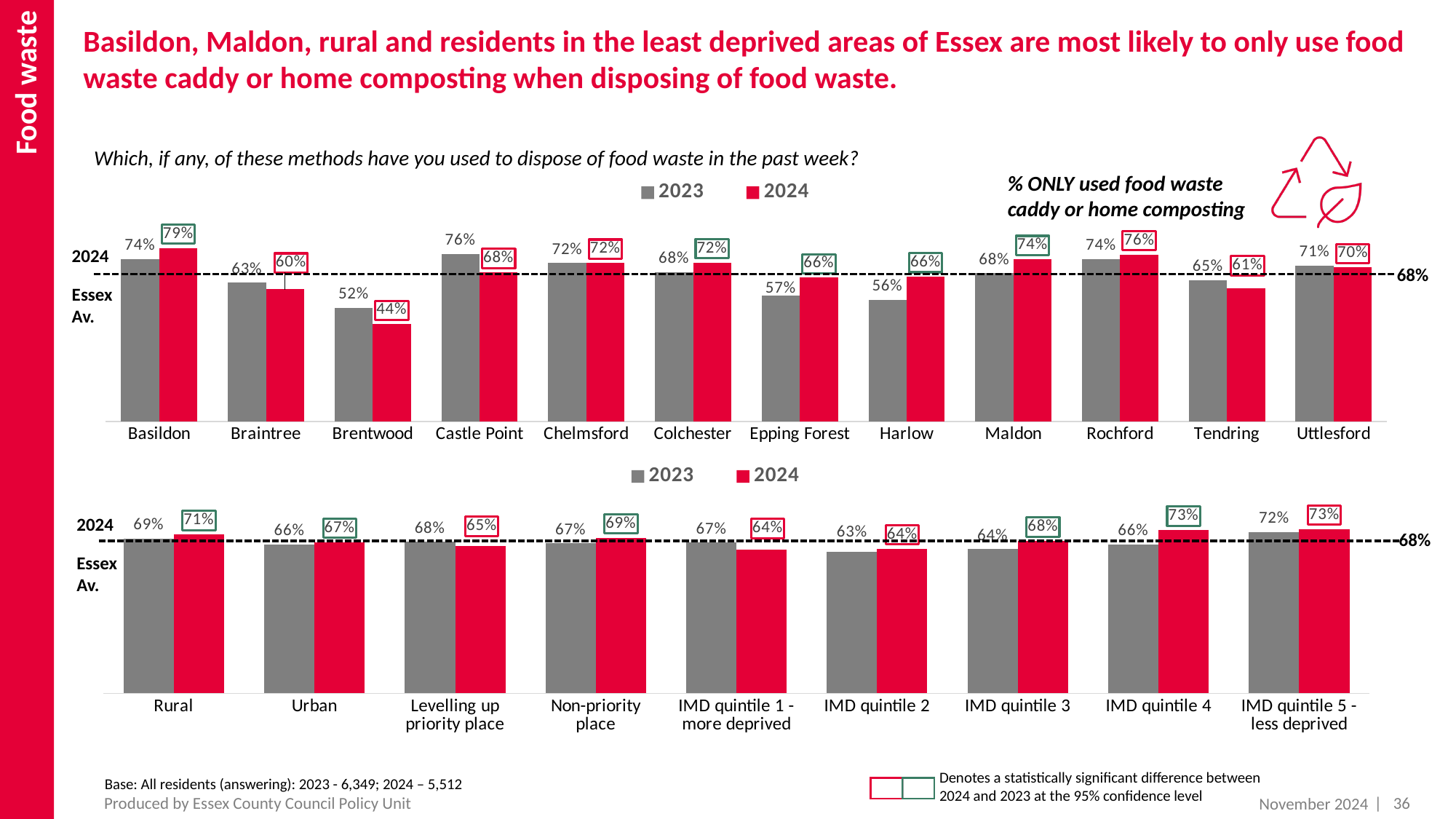
What type of chart is used on this slide? Bar chart In the top chart (by district), what is the 2023 value for Castle Point? 76% In the bottom chart, which category has the lowest 2023 value? IMD quintile 2 How many series does the legend of the top chart list? 2 In the bottom chart, what is the 2024 value for IMD quintile 4? 73% In the top chart (by district), what is the 2024 value for Basildon? 79% In the top chart (by district), how many districts are shown on the x axis? 12 In the top chart (by district), which district has the highest 2024 value? Basildon In the bottom chart, what is the difference between the 2023 and 2024 values for Levelling up priority place? 3 percentage points In the top chart (by district), which district has the lowest 2024 value? Brentwood In the bottom chart, is the 2024 value for Rural larger or smaller than the 2024 value for Urban? larger In the top chart (by district), what is the difference between the 2024 and 2023 values for Harlow? 10 percentage points